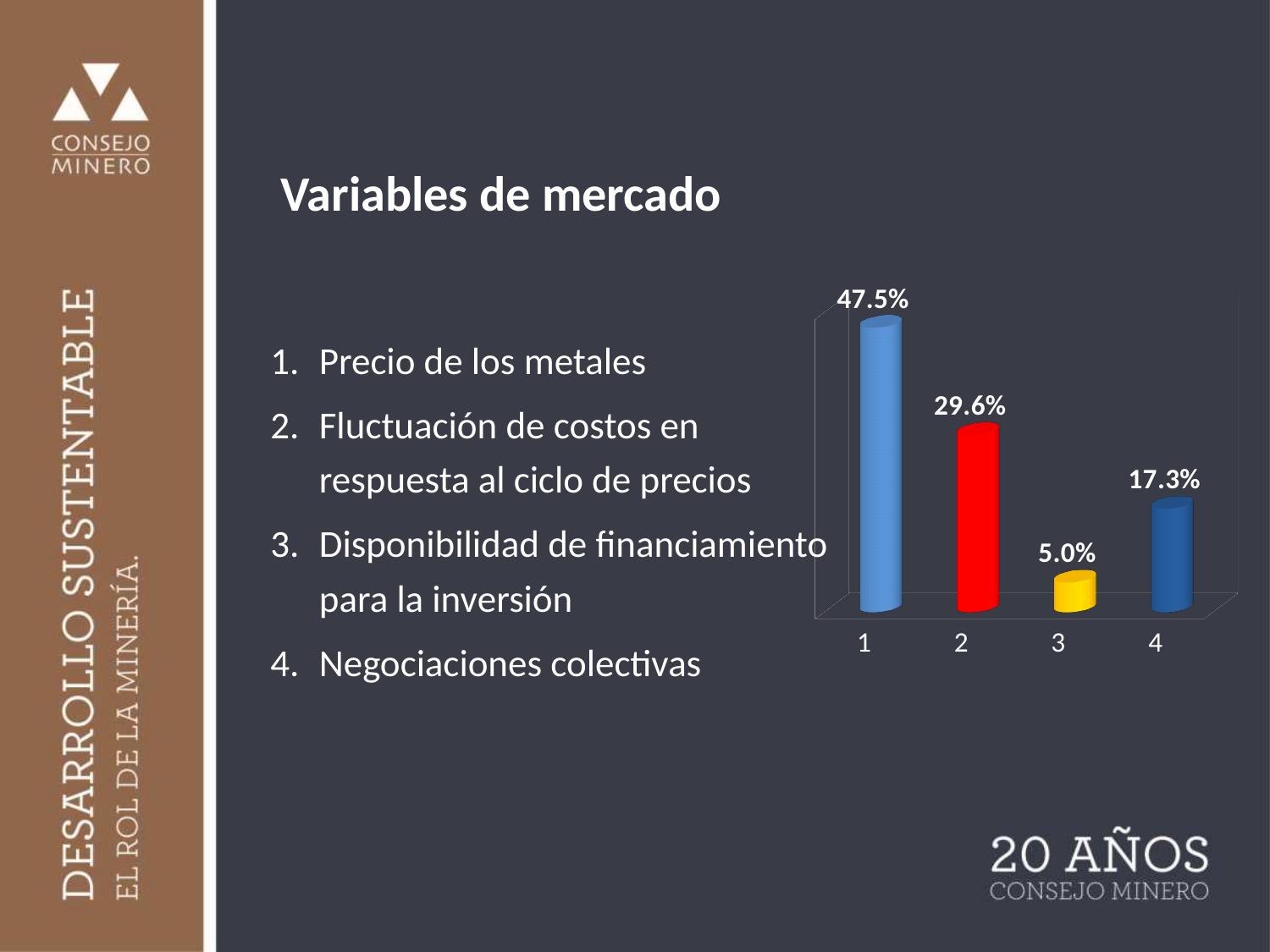
How many categories are shown in the chart? 4 Which is larger, the value for category 2 or the value for category 4? 2 What is the value for category 4 in the chart? 17.3% What is the difference between the values for category 4 and category 3? 12.3% What is the value for category 2 in the chart? 29.6% What kind of chart is shown on the slide? bar chart What is the value for category 1 in the chart? 47.5% What is the value for category 3 in the chart? 5.0% Which category has the highest value in the chart? 1 What is the difference between the values for category 1 and category 2? 17.9% Which category has the lowest value in the chart? 3 What colour is the bar for category 2? red